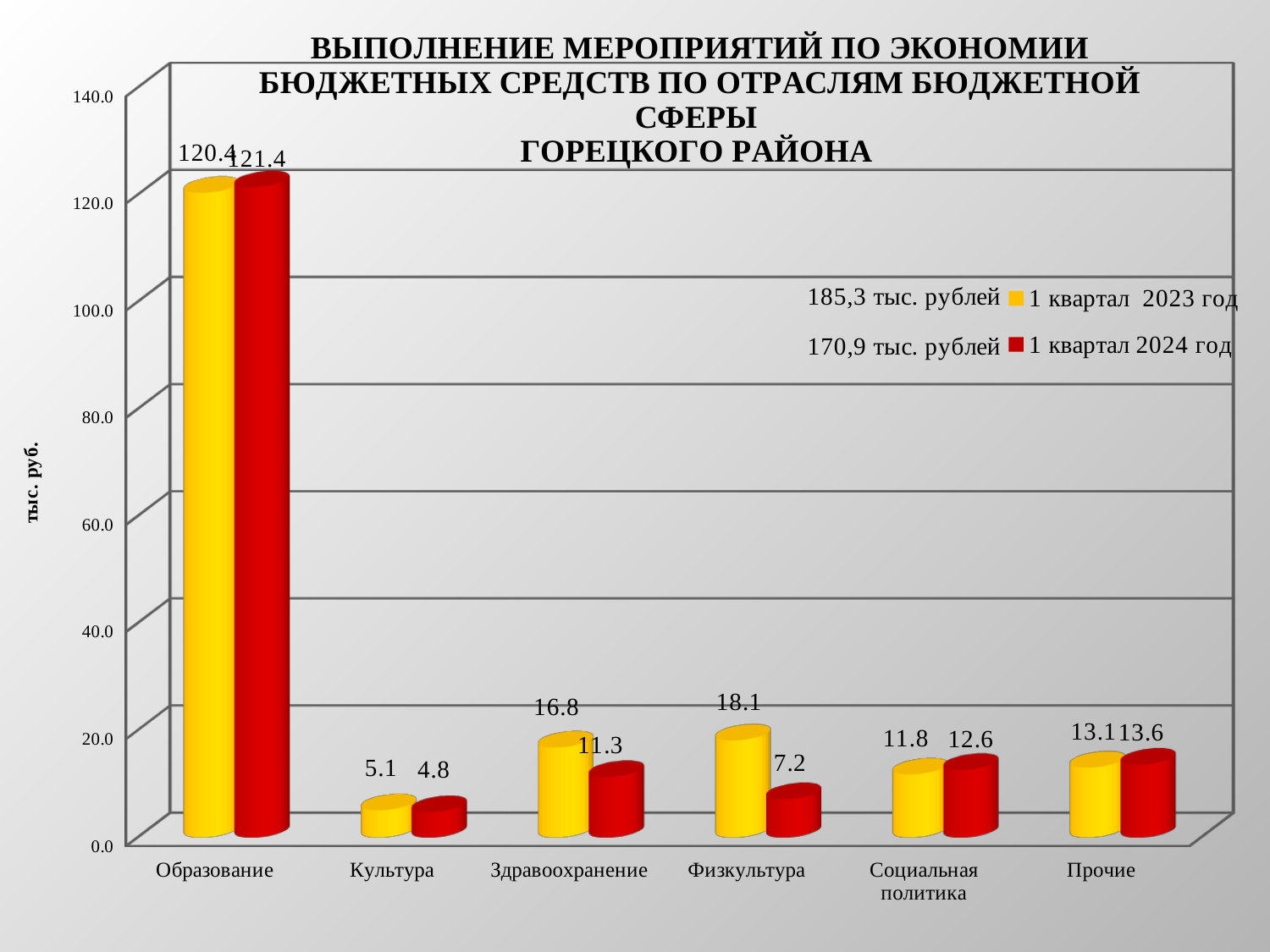
Which category has the lowest value in the 1 квартал 2023 год series? Культура What type of chart is shown on the slide? bar chart For Здравоохранение, which series has the larger value: 1 квартал 2023 год or 1 квартал 2024 год? 1 квартал 2023 год What is the value for Физкультура in the 1 квартал 2024 год series? 7.2 What is the difference between the 1 квартал 2023 год and 1 квартал 2024 год values for Физкультура? 10.9 Is the value for Образование in the 1 квартал 2024 год series greater or less than 100.0? greater How many series does the legend list? 2 What is the label of the vertical axis? тыс. руб. Which category has the highest value in the 1 квартал 2024 год series? Образование What is the value for Образование in the 1 квартал 2023 год series? 120.4 What is the value for Здравоохранение in the 1 квартал 2023 год series? 16.8 How many categories are shown on the x axis? 6